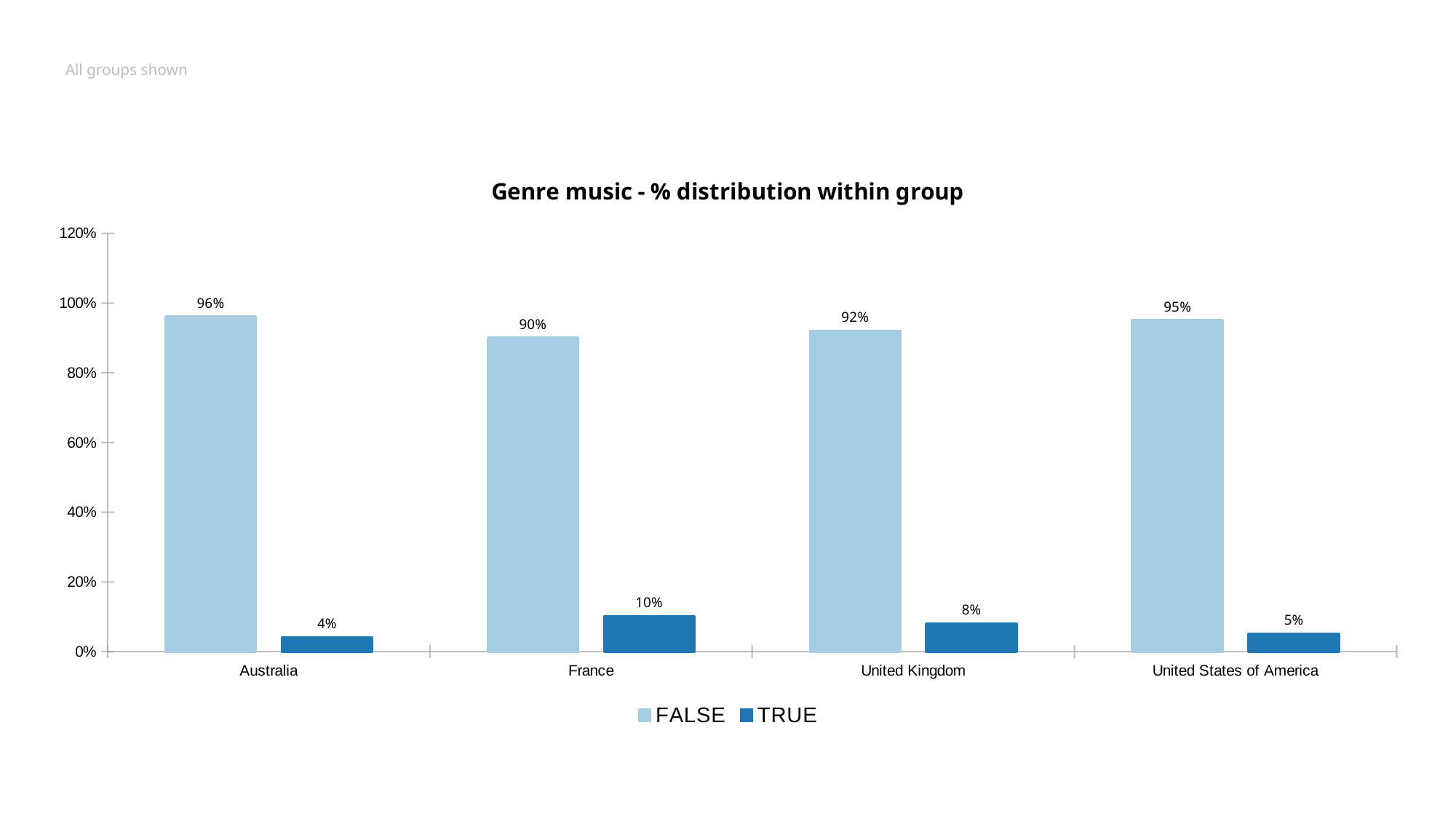
What kind of chart is shown on the slide? Bar chart Which is larger, the TRUE value for France or the TRUE value for Australia? France What is the difference between the FALSE and TRUE values for United Kingdom? 84% What is the FALSE value for United Kingdom? 92% What is the title of the chart? Genre music - % distribution within group What is the FALSE value for Australia? 96% How many series does the legend list? 2 Which country has the highest TRUE value? France What is the TRUE value for United States of America? 5% Which country has the lowest FALSE value? France How many countries are shown on the x axis? 4 What is the TRUE value for France? 10%